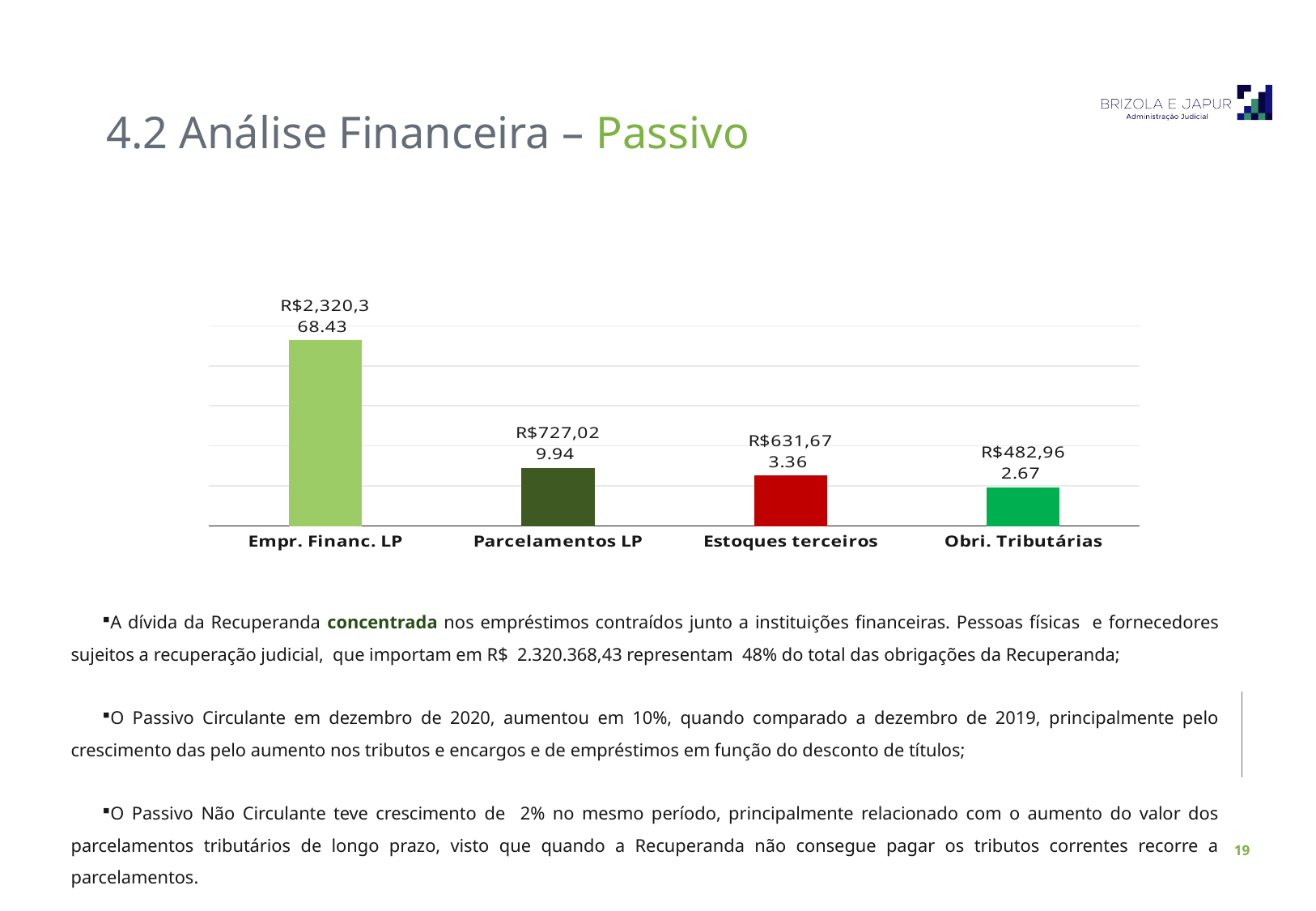
What kind of chart is shown on the slide? bar chart What value is labelled on the bar for Parcelamentos LP? R$727,029.94 Which is larger, the value for Estoques terceiros or the value for Obri. Tributárias? Estoques terceiros What colour is the bar for Empr. Financ. LP? light green Which is larger, the value for Parcelamentos LP or the value for Estoques terceiros? Parcelamentos LP Which category has the highest value in the chart? Empr. Financ. LP How many categories are plotted in the chart? 4 What colour is the bar for Estoques terceiros? red What value is labelled on the bar for Estoques terceiros? R$631,673.36 Which category has the lowest value in the chart? Obri. Tributárias Do the values rise or fall from left to right across the categories? fall What value is labelled on the bar for Obri. Tributárias? R$482,962.67